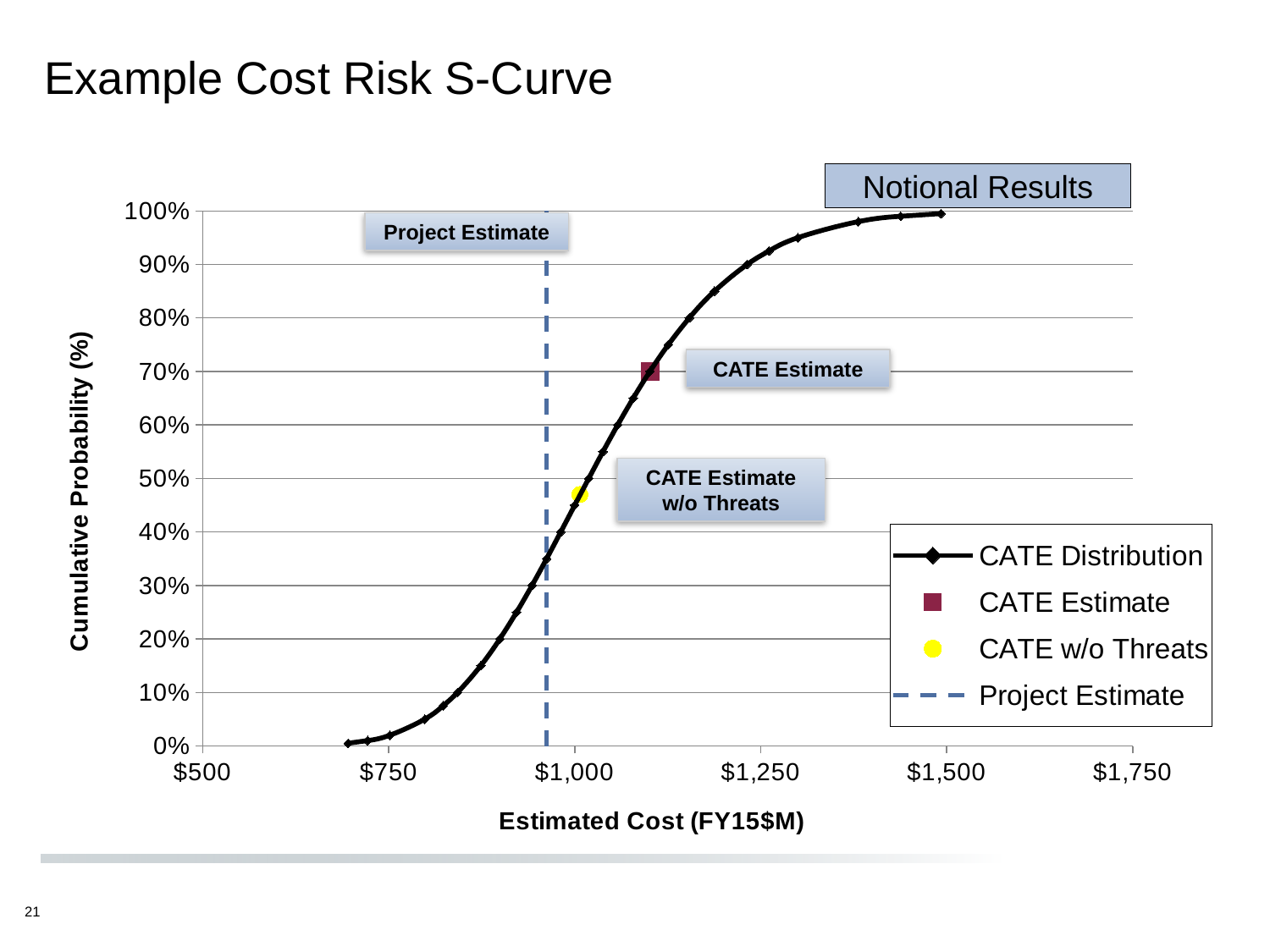
Is the cumulative probability at the Project Estimate line's intersection with the curve greater or less than 50%? less Does the CATE Distribution curve rise or fall as estimated cost increases along the x axis? rise Which has the higher estimated cost, the CATE Estimate or the CATE w/o Threats marker? CATE Estimate Is the estimated cost at the CATE Estimate marker greater or less than $1,000? greater How many series does the legend list? 4 Is the cumulative probability at the CATE Estimate marker greater or less than 60%? greater What colour is the CATE w/o Threats marker? yellow Which has the higher cumulative probability, the CATE Estimate or the CATE w/o Threats marker? CATE Estimate What kind of chart is shown on the slide? line chart What is the title of the x axis? Estimated Cost (FY15$M)